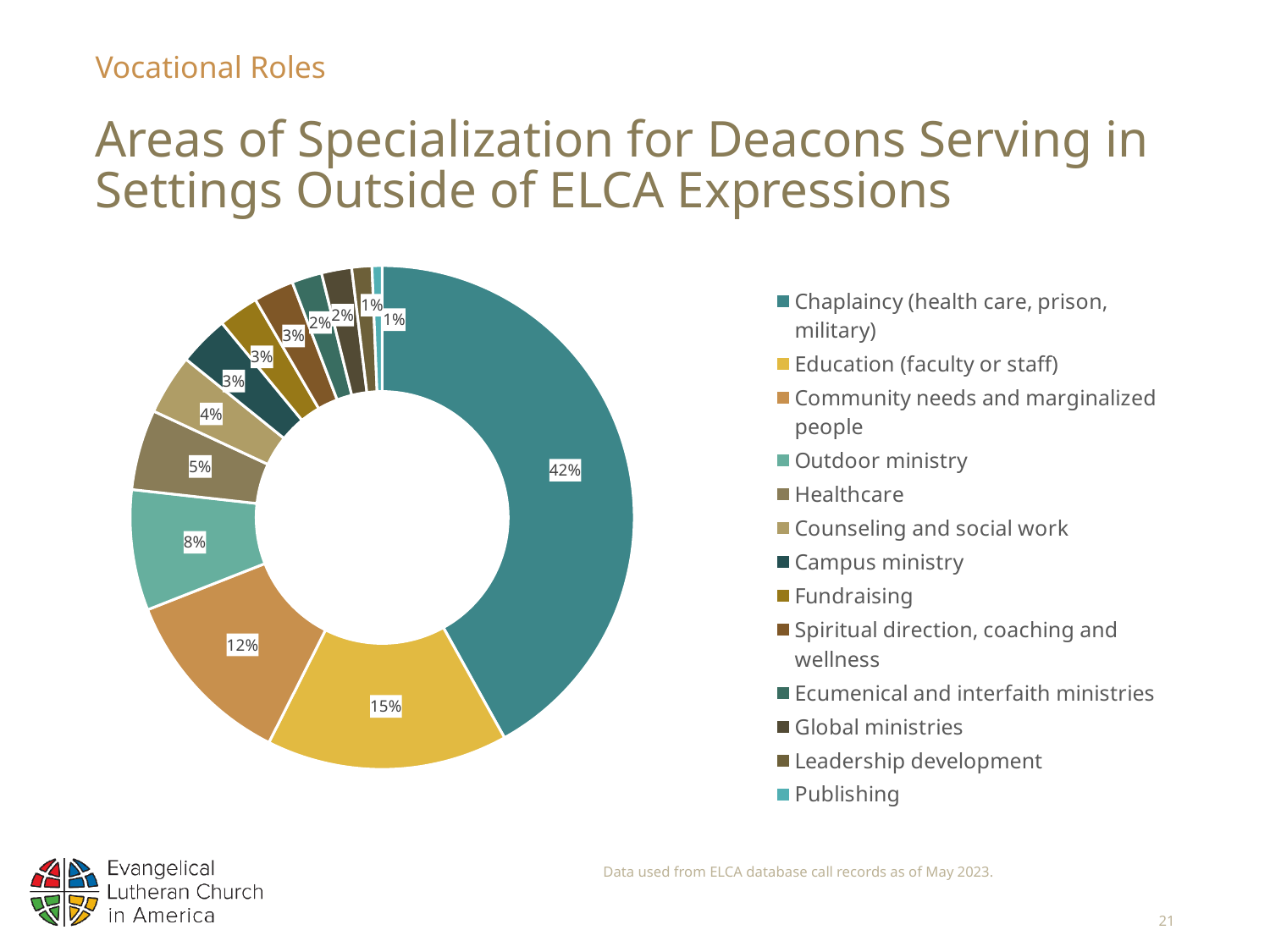
What percentage is shown for Community needs and marginalized people? 12% What type of chart is shown on the slide? Pie chart (doughnut) What is the combined share of Education (faculty or staff) and Community needs and marginalized people? 27% What is the title of the chart on the slide? Areas of Specialization for Deacons Serving in Settings Outside of ELCA Expressions What percentage is shown for Healthcare? 5% What percentage is shown for Education (faculty or staff)? 15% What is the difference in percentage points between Chaplaincy and Education (faculty or staff)? 27 What percentage is shown for Outdoor ministry? 8% Which area of specialization has the largest share of the pie? Chaplaincy (health care, prison, military) Which has a larger share: Outdoor ministry or Counseling and social work? Outdoor ministry How many areas of specialization does the legend list? 13 What share of the pie is Chaplaincy (health care, prison, military)? 42%